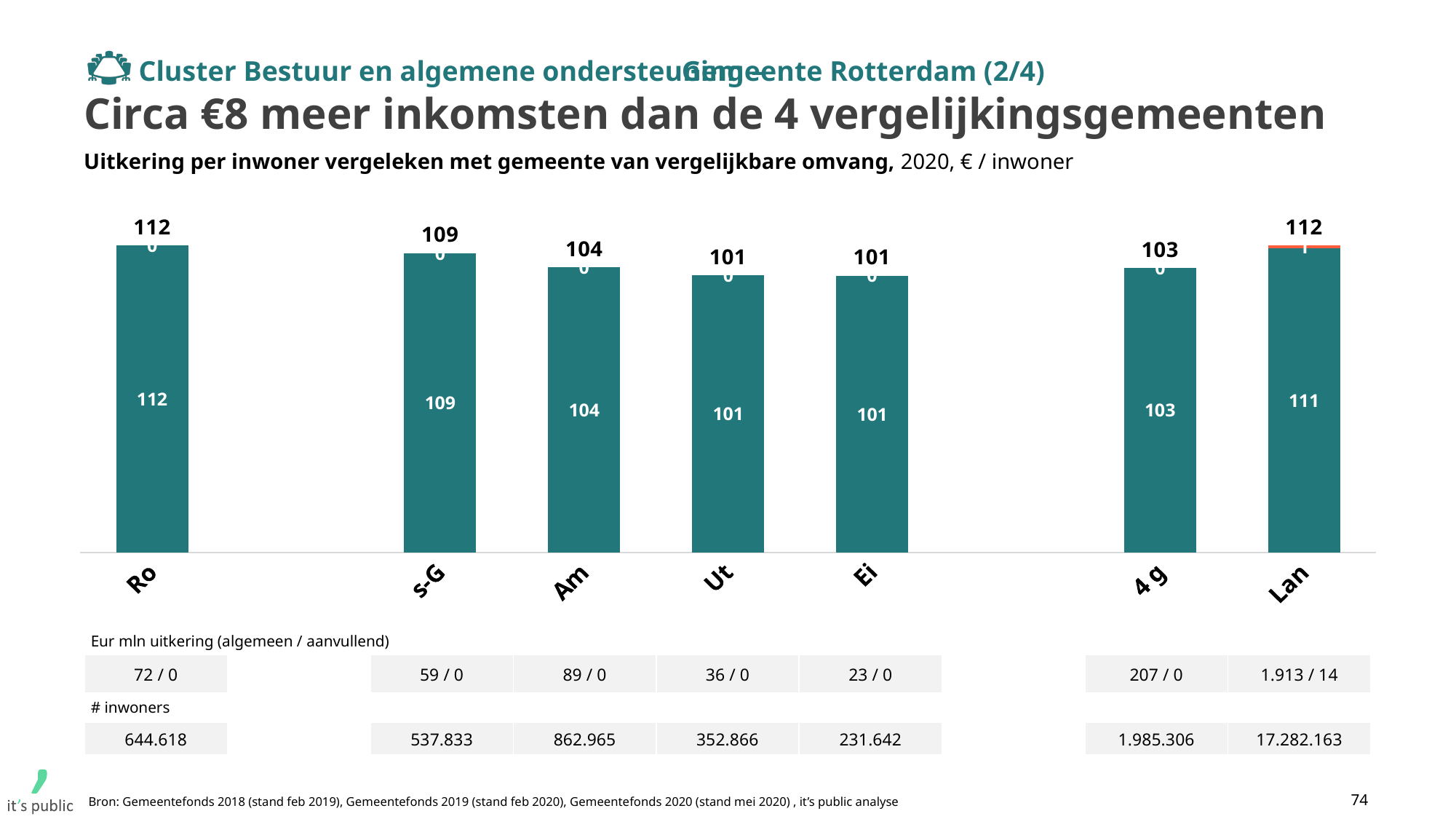
Which category has the lowest total value? Ut and Ei (both 101) What is the total value shown above the bar for Am? 104 What is the unit given in the chart subtitle? € / inwoner How many categories (bars) are shown in the chart? 7 Which bar has an orange segment on top? Lan Which is larger, the total for Am or the total for 4 g? Am What kind of chart is shown on the slide? Stacked bar chart What is the total value shown above the bar for Ro? 112 What is the difference between the total for Ro and the total for 4 g? 9 What is the difference between the total for 's-G and the total for Ut? 8 What is the value of the teal segment of the Lan bar? 111 What is the total of the stacked bar for Lan? 112